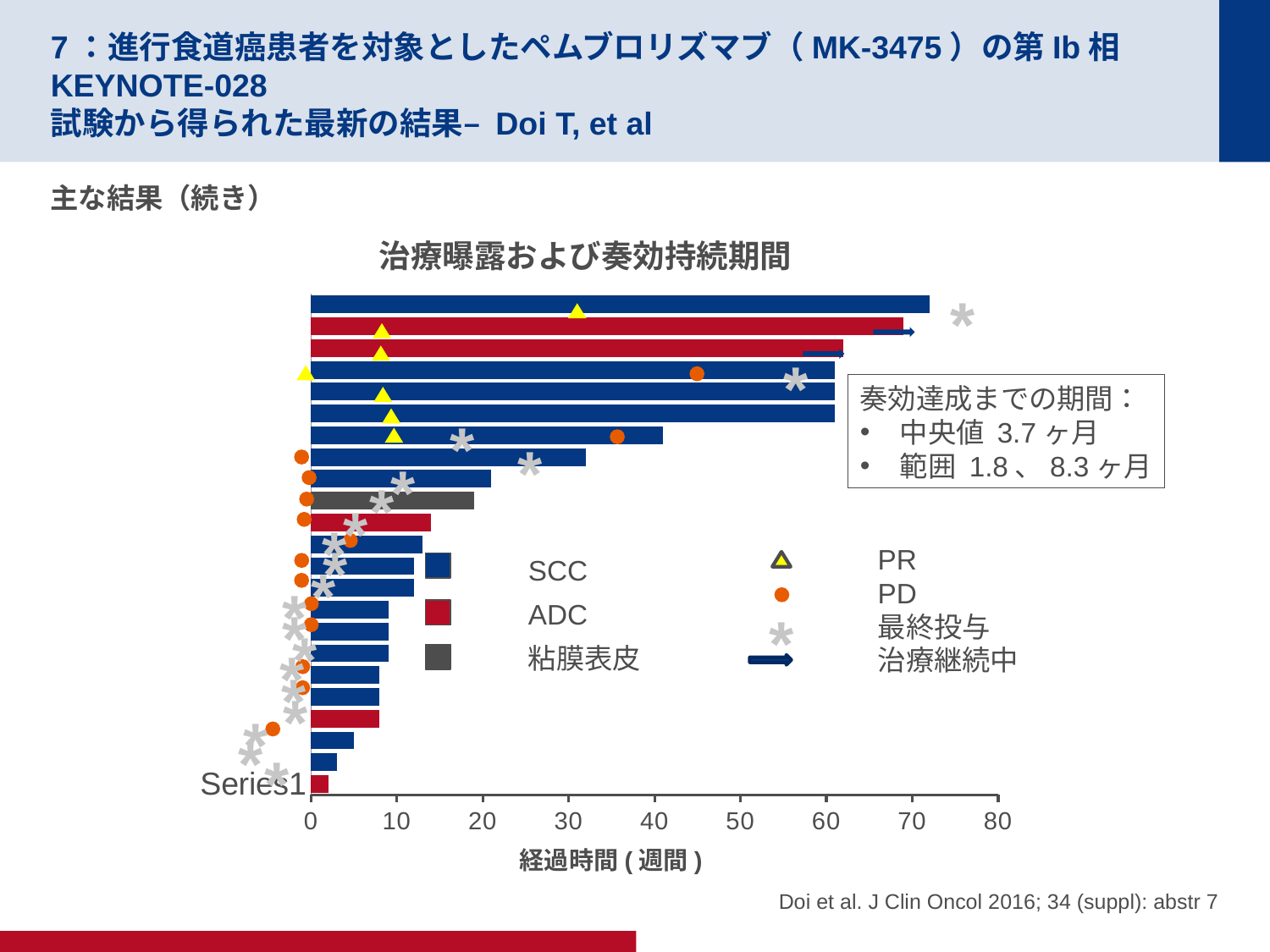
How many entries does the chart legend list? 7 What kind of chart is shown on the slide? bar chart Is the shortest bar in the chart greater or less than 10 weeks? less Which histology group (SCC, ADC or 粘膜表皮) has the longest bar in the chart? SCC Which colour represents SCC in the chart legend? blue Is the grey (粘膜表皮) bar greater or less than 30 weeks? less Do the bar lengths increase or decrease going from the top of the chart to the bottom? decrease Is the longest bar in the chart greater or less than 70 weeks? greater According to the annotation on the chart, what is the median time to response? 3.7 ヶ月 What is the title of the chart? 治療曝露および奏効持続期間 Which is longer: the longest blue (SCC) bar or the grey (粘膜表皮) bar? the longest blue (SCC) bar